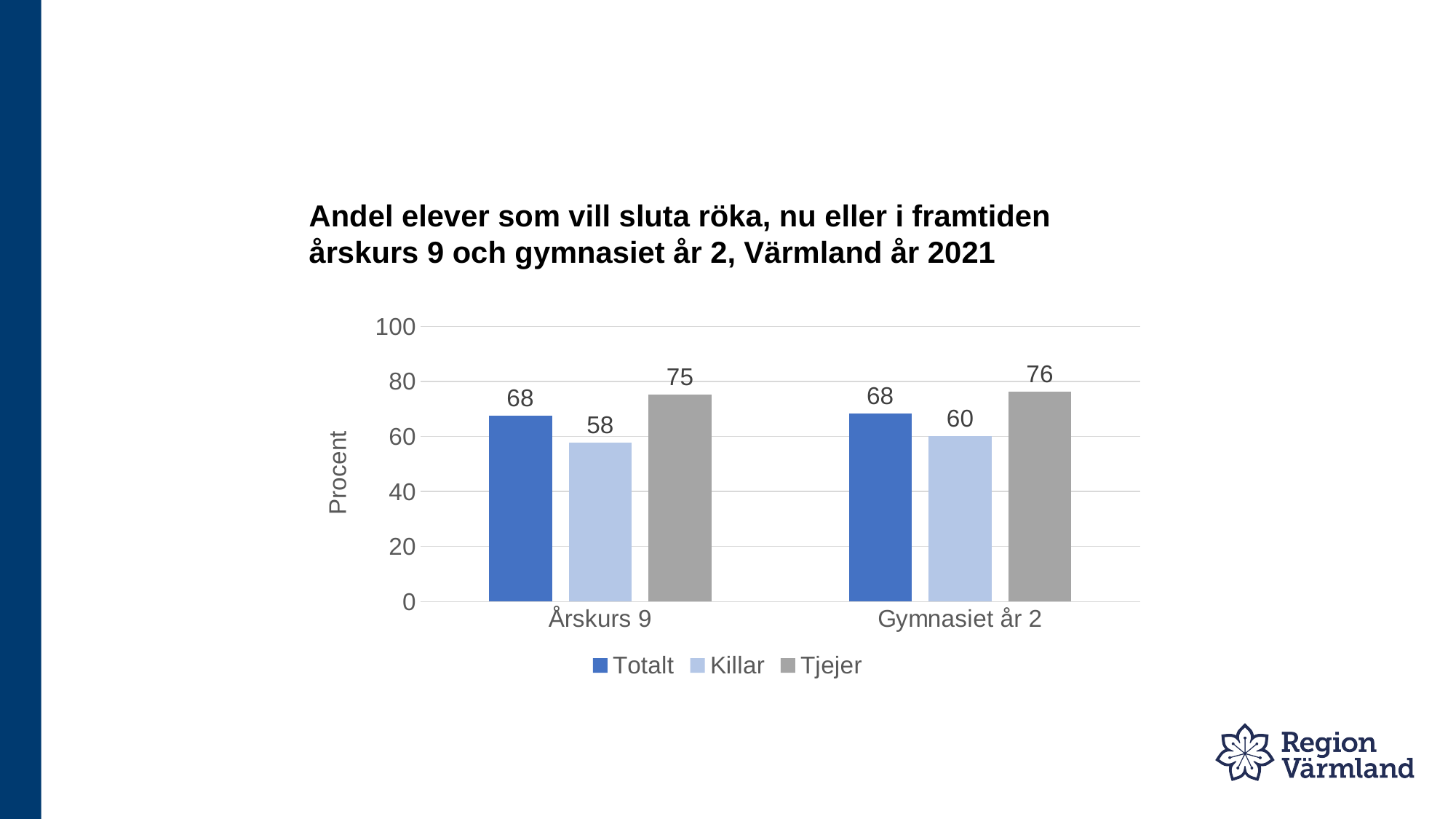
How many series does the legend list? 3 What is the difference between Tjejer and Killar in Årskurs 9? 17 Which series has the lowest value in Gymnasiet år 2? Killar What is the value for Killar in Årskurs 9? 58 What is the difference between Killar in Gymnasiet år 2 and Killar in Årskurs 9? 2 What is the value for Tjejer in Gymnasiet år 2? 76 What is the label of the vertical axis? Procent What kind of chart is shown on the slide? Bar chart What is the value for Totalt in Gymnasiet år 2? 68 Which series has the highest value in Årskurs 9? Tjejer Which is larger: Tjejer in Årskurs 9 or Totalt in Gymnasiet år 2? Tjejer in Årskurs 9 Is the value for Killar in Årskurs 9 greater or less than 60? less